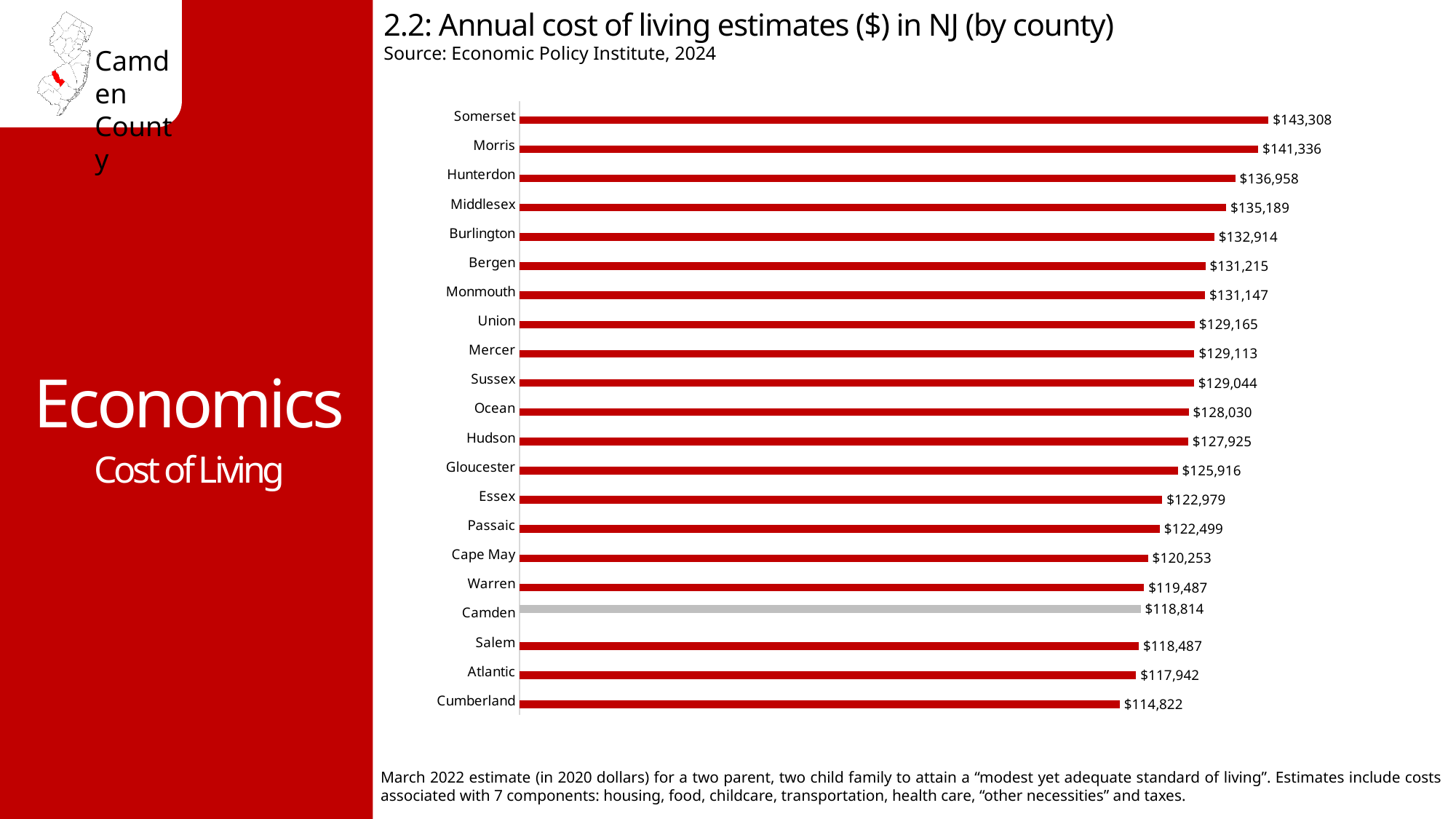
What is the annual cost of living estimate for Cape May county? $120,253 Which county has the lowest annual cost of living estimate? Cumberland How many counties are shown in the chart? 21 Which county has the highest annual cost of living estimate? Somerset What is the annual cost of living estimate for Camden county? $118,814 Which county's bar is shown in grey rather than red? Camden What kind of chart is used to show the cost of living estimates? Bar chart Which county has a higher cost of living estimate, Atlantic or Warren? Warren What is the difference between the cost of living estimates for Somerset and Cumberland? $28,486 Which county has a higher cost of living estimate, Essex or Gloucester? Gloucester What is the annual cost of living estimate for Bergen county? $131,215 What is the difference between the cost of living estimates for Morris and Hunterdon? $4,378